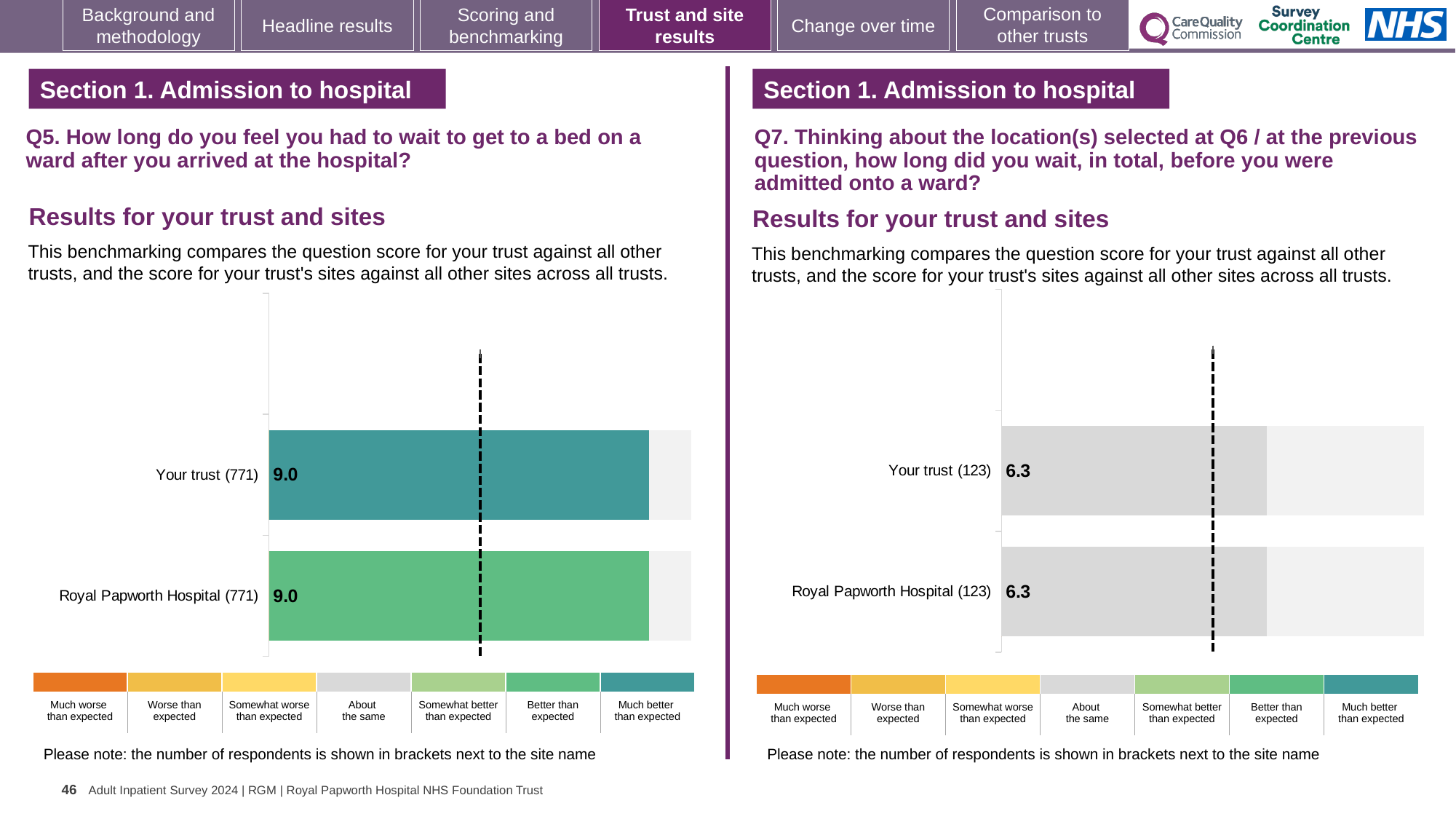
In the Q7 chart on the right, is the score for Your trust greater or less than the score for Your trust in the Q5 chart on the left? less In the Q5 chart on the left, what is the score for Your trust? 9.0 In the Q5 chart on the left, how many respondents are shown in brackets next to Your trust? 771 What kind of chart is the Q5 chart on the left? Bar chart In the Q7 chart on the right, what is the score for Your trust? 6.3 In the Q7 chart on the right, how many respondents are shown in brackets next to Royal Papworth Hospital? 123 In the Q7 chart on the right, what is the difference between the score for Your trust and the score for Royal Papworth Hospital? 0.0 In the Q5 chart on the left, what is the score for Royal Papworth Hospital? 9.0 How many bars are plotted in the Q7 chart on the right? 2 In the Q5 chart on the left, what is the difference between the score for Your trust and the score for Royal Papworth Hospital? 0.0 How many bars are plotted in the Q5 chart on the left? 2 In the Q7 chart on the right, what is the score for Royal Papworth Hospital? 6.3